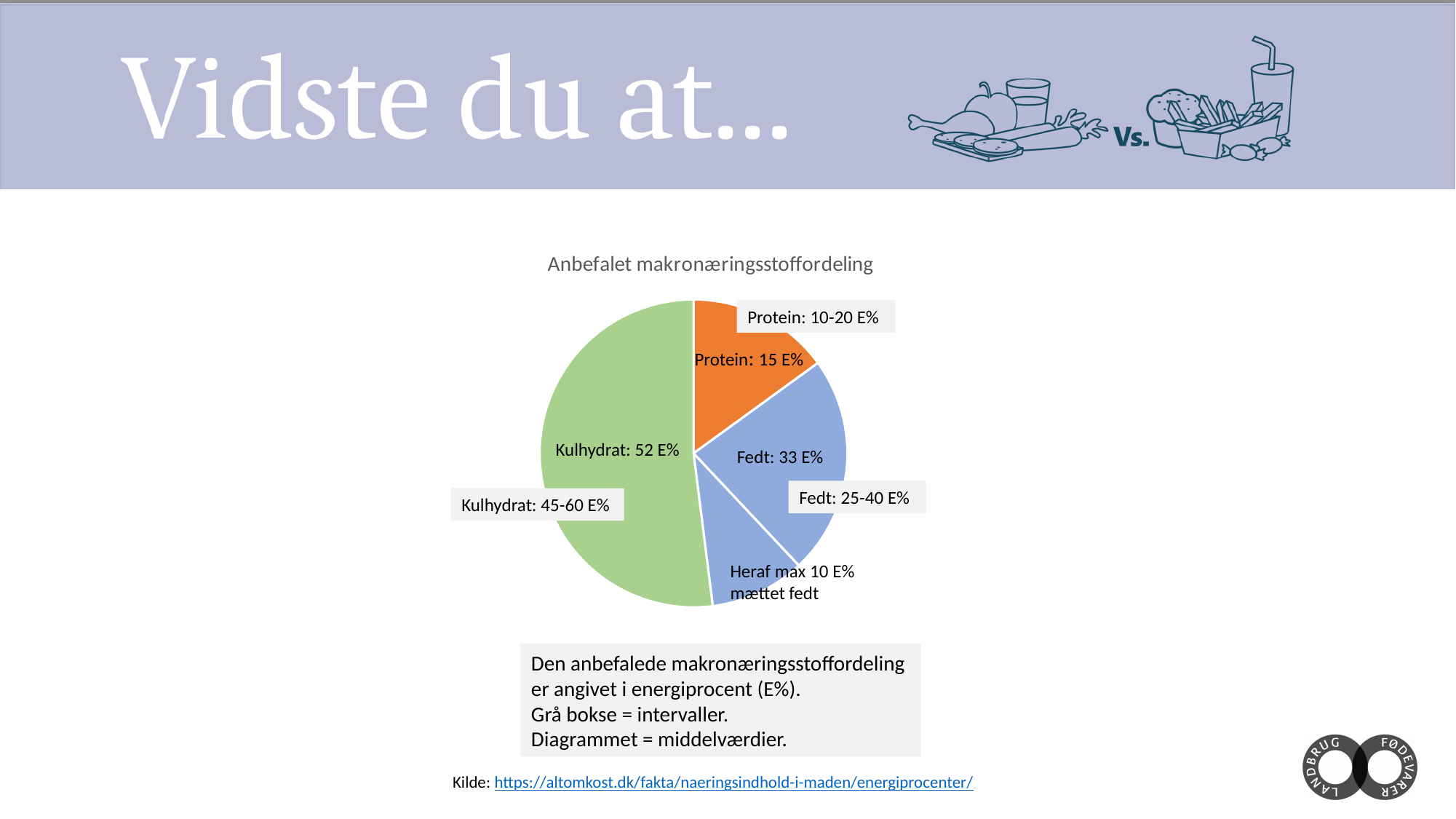
What is the value shown for Fedt in the pie chart? 33 E% Which is larger, the value for Fedt or the value for Protein? Fedt What is the difference between the Fedt value and the Protein value? 18 E% Which macronutrient has the largest slice in the pie chart? Kulhydrat What kind of chart is shown on the slide? Pie chart What is the title of the pie chart? Anbefalet makronæringsstoffordeling What is the value shown for Kulhydrat in the pie chart? 52 E% Which macronutrient has the smallest slice in the pie chart? Mættet fedt What is the maximum recommended value for mættet fedt according to the chart label? 10 E% What is the recommended interval for Kulhydrat shown in the grey box? 45-60 E% What is the difference between the Kulhydrat value and the Fedt value? 19 E% What is the value shown for Protein in the pie chart? 15 E%